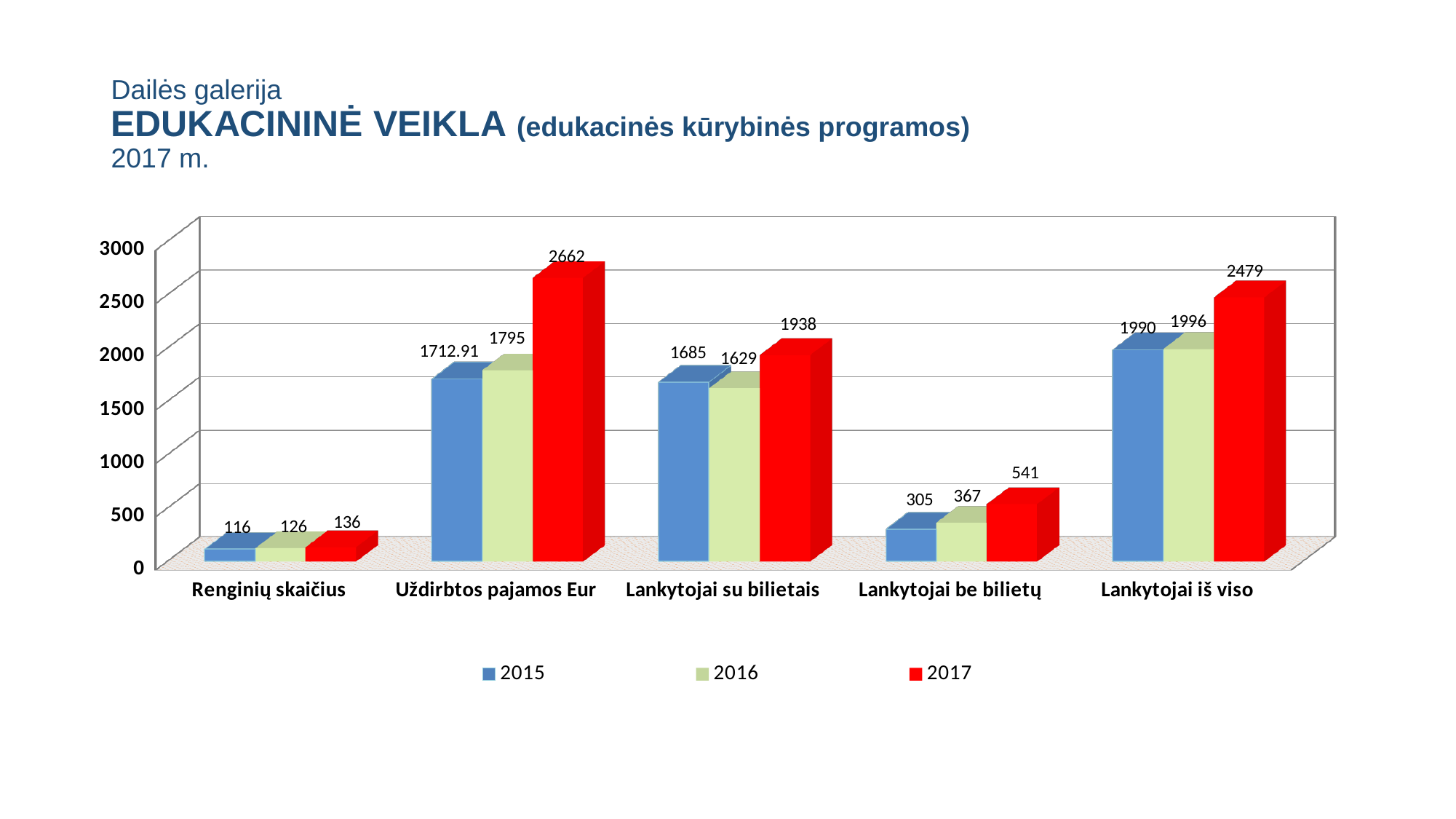
What is the value for 2017 in the Uždirbtos pajamos Eur category? 2662 What is the value for 2015 in the Lankytojai su bilietais category? 1685 Which category has the lowest value for 2015? Renginių skaičius What kind of chart is shown on the slide? Bar chart What is the difference between the 2017 and 2016 values for Lankytojai be bilietų? 174 What is the value for 2016 in the Renginių skaičius category? 126 Which is larger in the Lankytojai su bilietais category: the 2015 value or the 2016 value? 2015 What is the value for 2015 in the Uždirbtos pajamos Eur category? 1712.91 Which category has the highest value for 2017? Uždirbtos pajamos Eur How many series does the legend list? 3 How many categories are shown on the x axis? 5 Which colour represents the 2017 series in the legend? Red